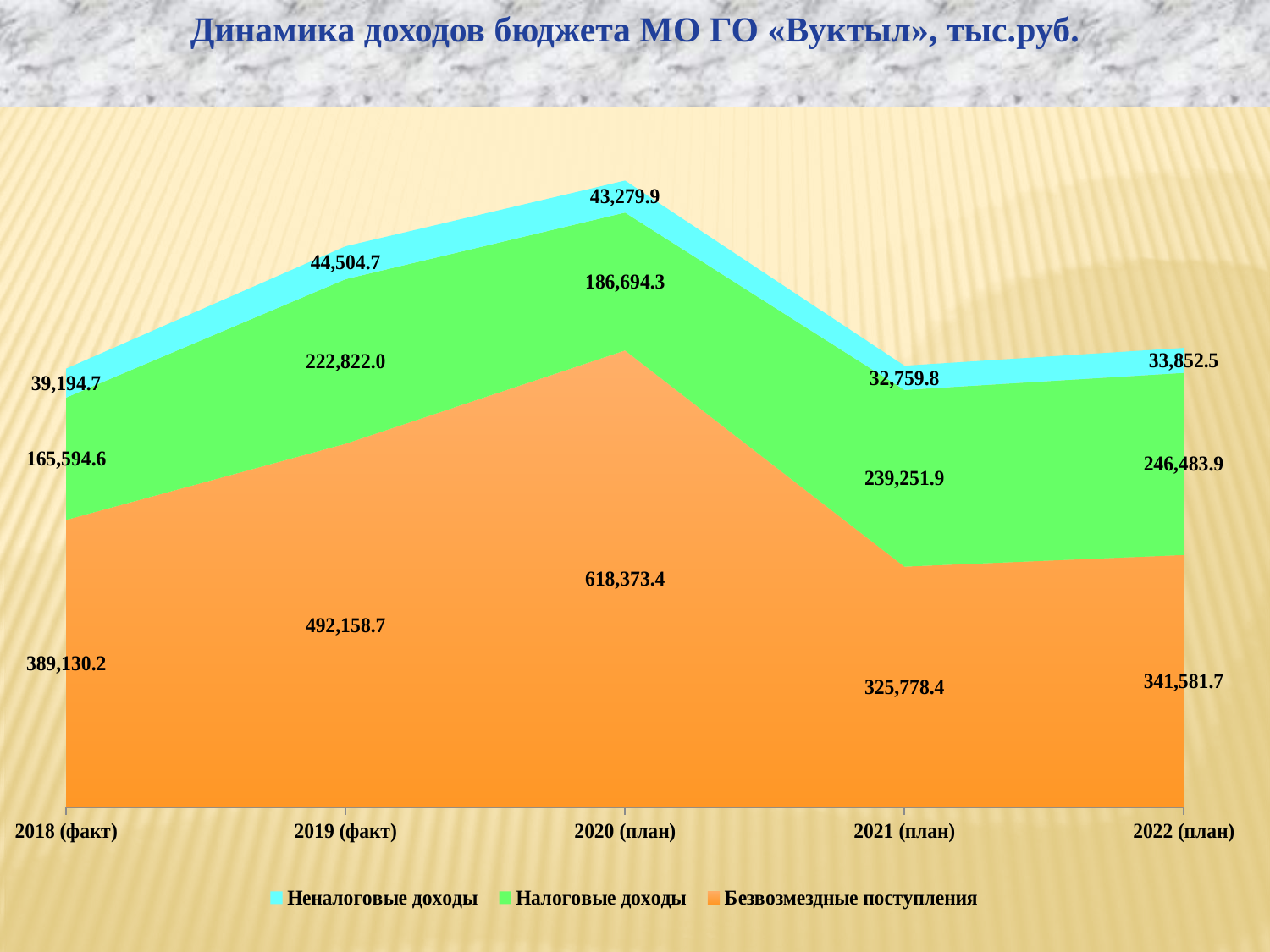
By how much does Безвозмездные поступления in 2020 (план) exceed that in 2019 (факт)? 126,214.7 How many periods (categories) are shown along the x axis? 5 Which is larger: Налоговые доходы in 2021 (план) or in 2020 (план)? 2021 (план) In which period is Неналоговые доходы the lowest? 2021 (план) In which period is Налоговые доходы the highest? 2022 (план) How many series does the legend list? 3 What is the value of Безвозмездные поступления for 2020 (план)? 618,373.4 What is the value of Налоговые доходы for 2019 (факт)? 222,822.0 What is the value of Неналоговые доходы for 2022 (план)? 33,852.5 What is the total of all three series for 2018 (факт)? 593,919.5 In which period is Безвозмездные поступления the highest? 2020 (план) What type of chart is shown on the slide? Stacked area chart